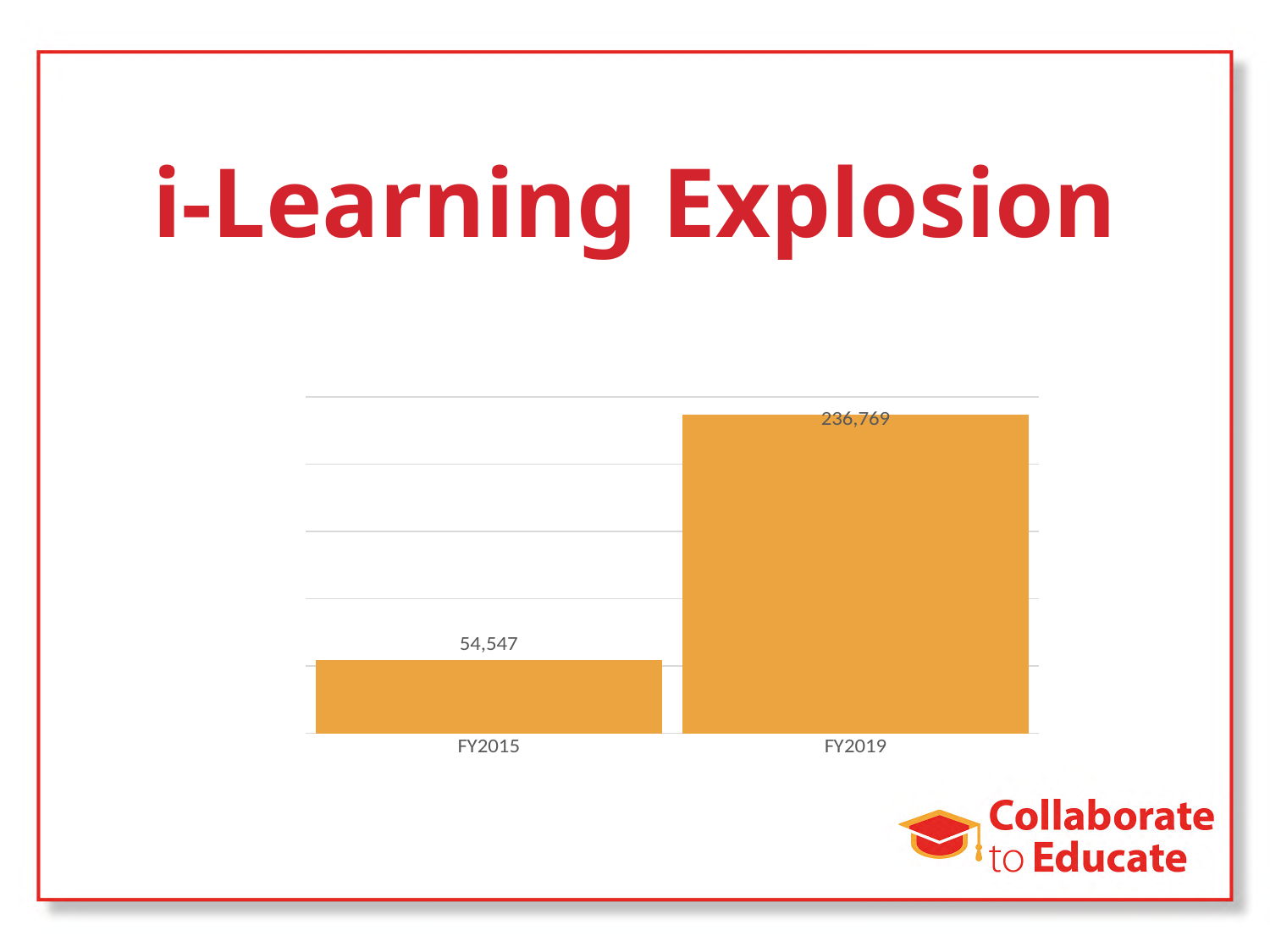
What is the value for FY2019? 236,769 What colour are the bars in the chart? orange Which category has the highest value? FY2019 Which category has the lowest value? FY2015 Do the values rise or fall from FY2015 to FY2019? rise What is the difference between the FY2019 value and the FY2015 value? 182,222 What is the value for FY2015? 54,547 What is the title of the slide containing the chart? i-Learning Explosion What kind of chart is shown on the slide? bar chart Which is larger, the value for FY2015 or the value for FY2019? FY2019 How many categories are shown on the x axis? 2